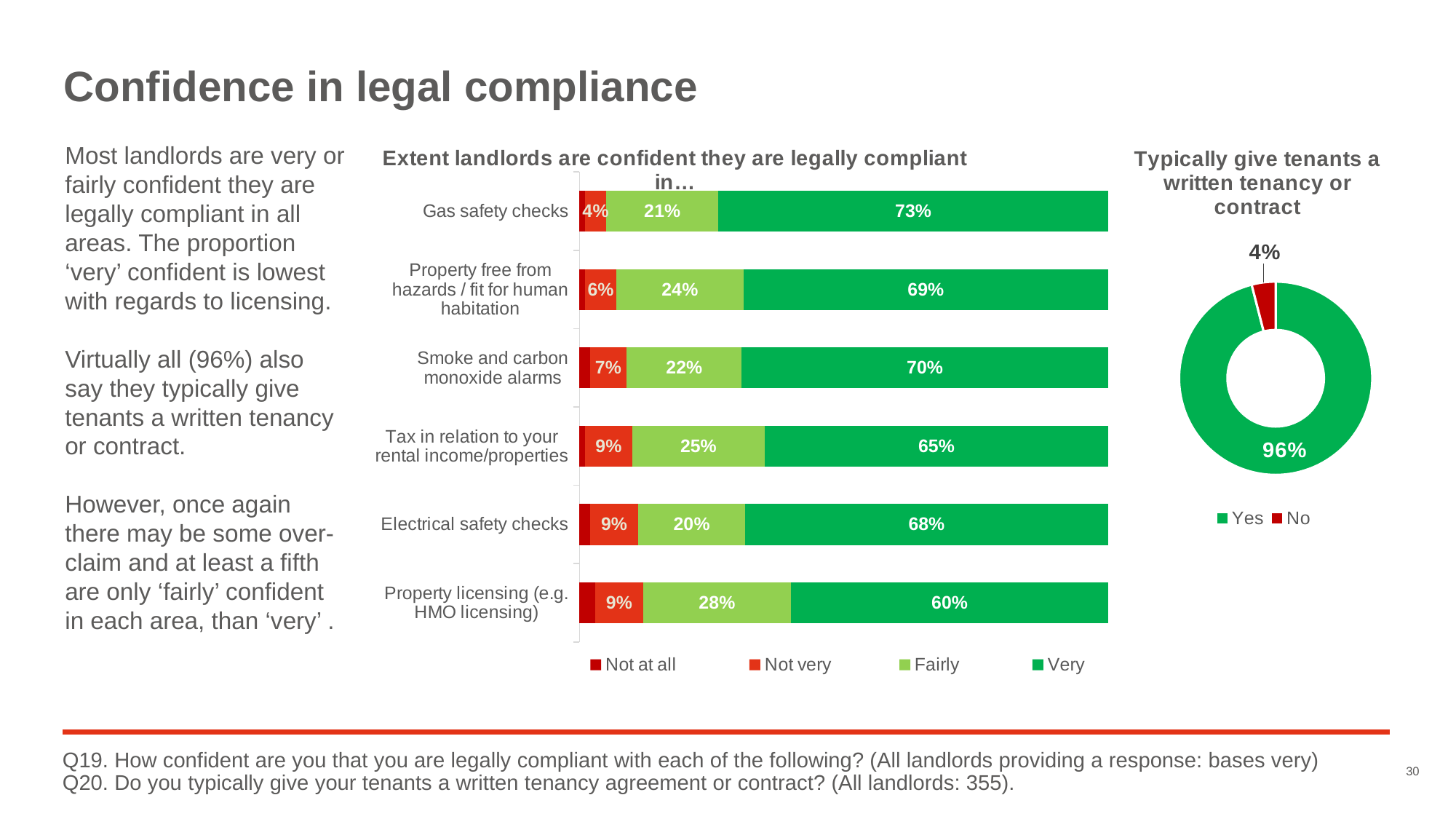
In the chart 'Extent landlords are confident they are legally compliant in…', what percentage of landlords are 'Very' confident about gas safety checks? 73% In the chart 'Extent landlords are confident they are legally compliant in…', which area has the lowest 'Very' confident percentage? Property licensing (e.g. HMO licensing) In the chart 'Extent landlords are confident they are legally compliant in…', how many percentage points higher is the 'Very' value for gas safety checks than for property licensing? 13 percentage points In the chart 'Extent landlords are confident they are legally compliant in…', which area has the highest 'Very' confident percentage? Gas safety checks How many compliance areas are listed in the chart 'Extent landlords are confident they are legally compliant in…'? 6 How many series does the legend of the chart 'Extent landlords are confident they are legally compliant in…' list? 4 In the chart 'Extent landlords are confident they are legally compliant in…', which has the larger 'Fairly' value: tax in relation to your rental income/properties or electrical safety checks? Tax in relation to your rental income/properties In the chart 'Typically give tenants a written tenancy or contract', what share of the chart is 'No'? 4% In the chart 'Typically give tenants a written tenancy or contract', what percentage of landlords answered 'Yes'? 96% In the chart 'Extent landlords are confident they are legally compliant in…', what is the 'Not very' value for smoke and carbon monoxide alarms? 7% What kind of chart is 'Extent landlords are confident they are legally compliant in…'? Stacked bar chart In the chart 'Extent landlords are confident they are legally compliant in…', what percentage are 'Fairly' confident about property licensing (e.g. HMO licensing)? 28%